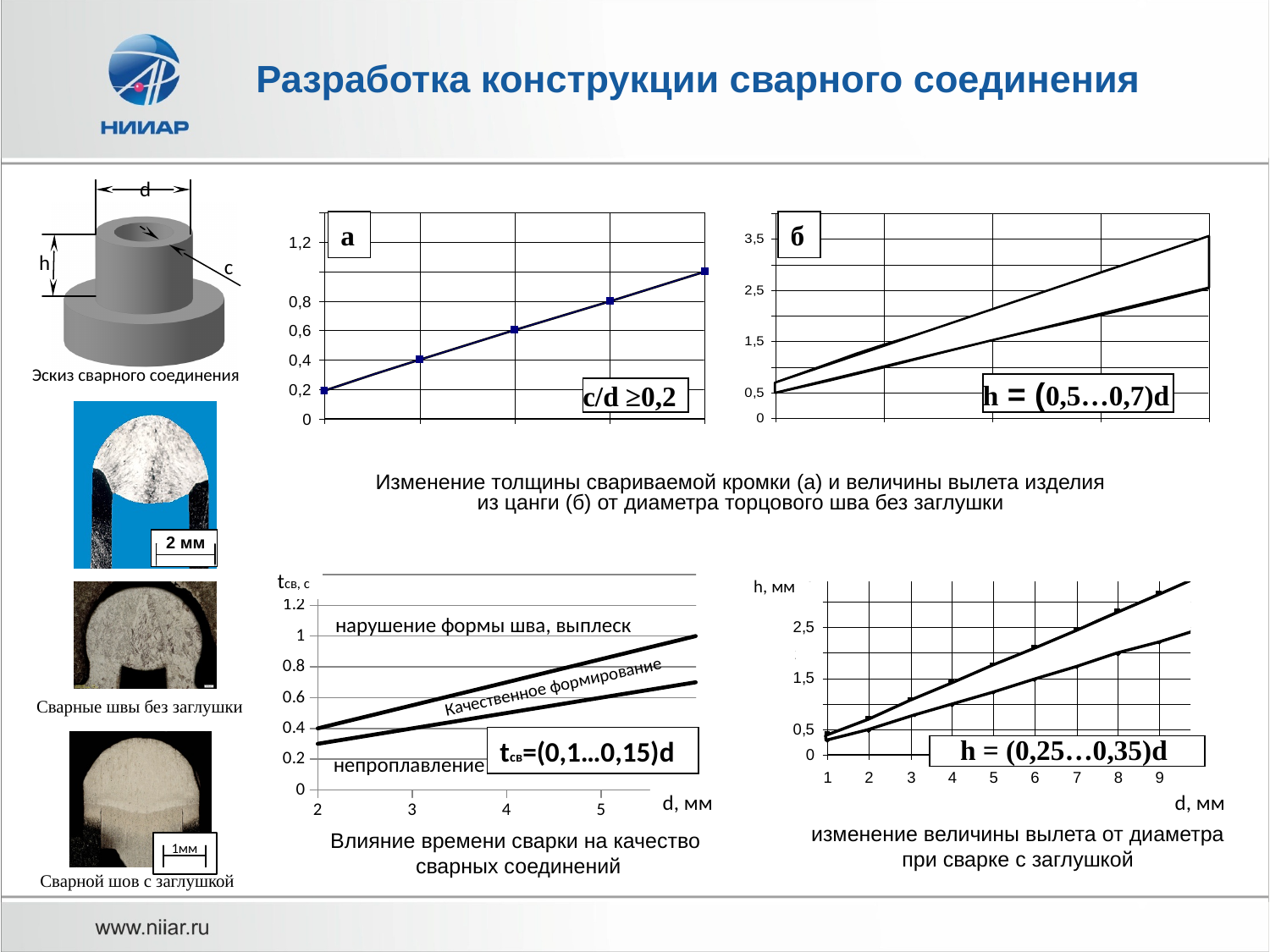
On chart «а» (top left of the two upper charts), what is the value of the fourth data point from the left? 0,8 On the chart «изменение величины вылета от диаметра при сварке с заглушкой» (bottom right), how many tick labels are shown on the d, мм axis? 9 On the chart «изменение величины вылета от диаметра при сварке с заглушкой» (bottom right), is the value of the upper line at d = 8 мм greater or less than 2,5? greater What formula is printed in the box on chart «а» (top left of the two upper charts)? c/d ≥0,2 What formula is printed in the box on chart «б» (top right)? h = (0,5…0,7)d On chart «б» (top right), do the plotted lines rise or fall from left to right? rise On chart «а» (top left of the two upper charts), what is the value of the first (leftmost) data point? 0,2 On chart «б» (top right), how many lines are plotted? 2 On chart «а» (top left of the two upper charts), do the values rise or fall from left to right? rise What kind of chart is chart «а» (top left of the two upper charts)? line chart On chart «а» (top, left of the two upper charts), how many data points are plotted on the line? 5